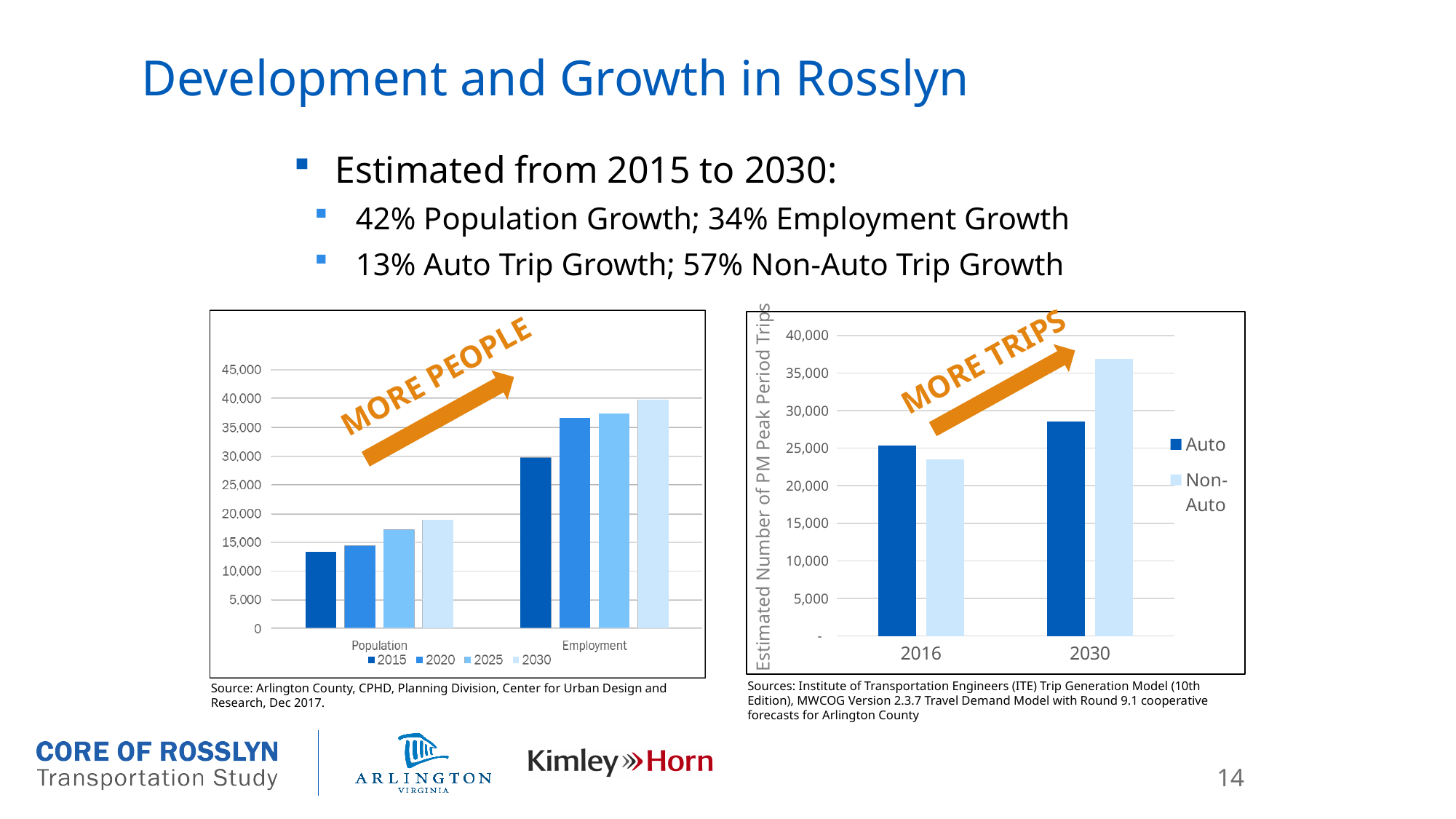
In the right chart (labelled 'MORE TRIPS'), is the Non-Auto value for 2030 greater or less than 35,000? greater What kind of chart is the left chart (labelled 'MORE PEOPLE')? bar chart In the right chart (labelled 'MORE TRIPS'), what is the title of the vertical axis? Estimated Number of PM Peak Period Trips In the left chart (labelled 'MORE PEOPLE'), do the Population values rise or fall from 2015 to 2030? rise In the left chart (labelled 'MORE PEOPLE'), is the Employment value for 2015 greater or less than 25,000? greater In the left chart (labelled 'MORE PEOPLE'), how many categories are shown on the x axis? 2 In the left chart (labelled 'MORE PEOPLE'), is the Population value for 2030 greater or less than 20,000? less In the left chart (labelled 'MORE PEOPLE'), how many series does the legend list? 4 In the right chart (labelled 'MORE TRIPS'), how many series does the legend list? 2 In the left chart (labelled 'MORE PEOPLE'), which is larger for Population: the 2015 value or the 2030 value? 2030 In the right chart (labelled 'MORE TRIPS'), which is larger in 2016: Auto or Non-Auto? Auto